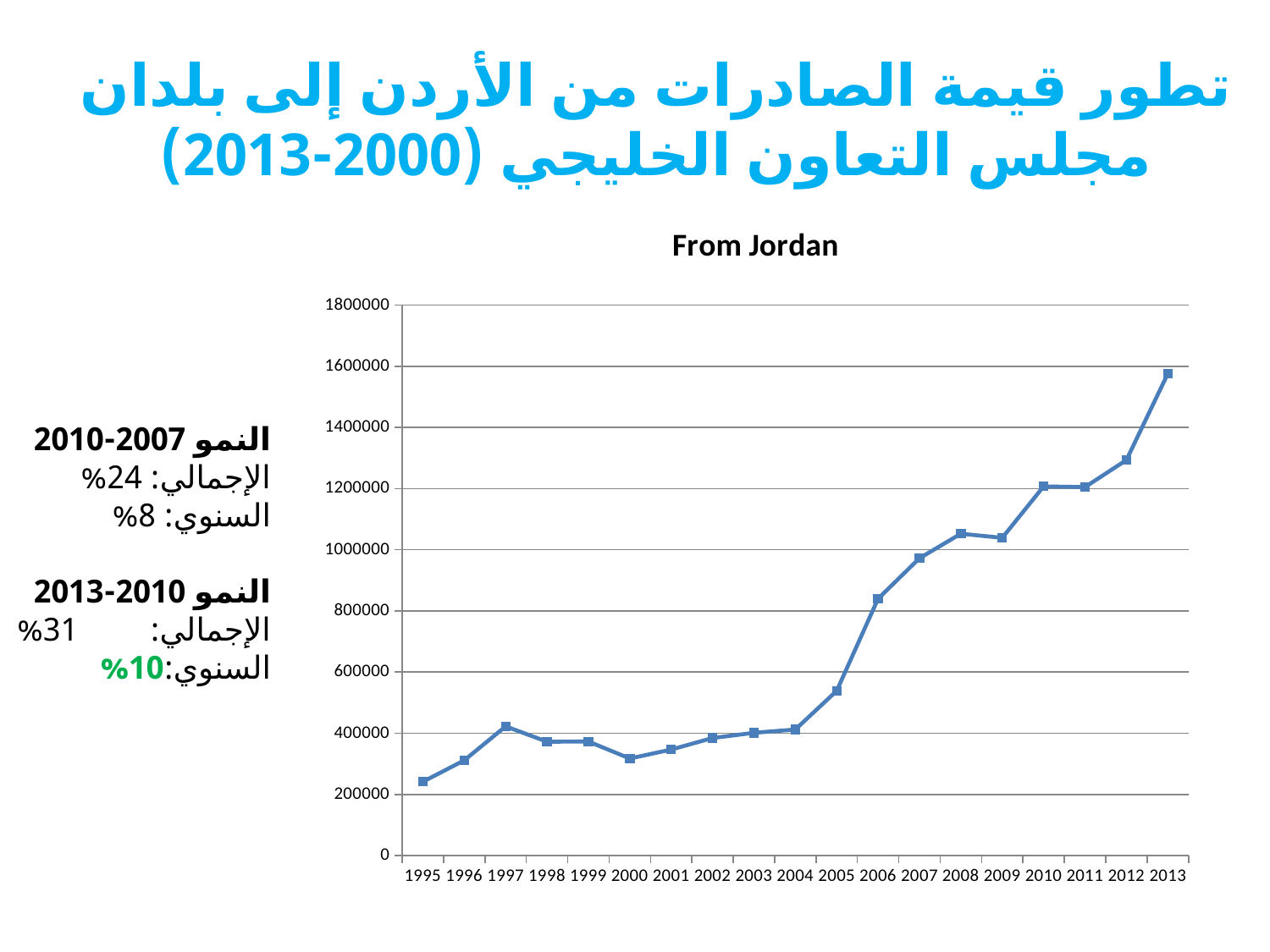
What kind of chart is shown on the slide? line chart Is the value for 2007 greater or less than 1000000? less How many years are plotted on the x axis of the chart? 19 Is the value for 2012 greater or less than 1200000? greater Which year has the highest value in the chart? 2013 Is the value for 2005 greater or less than 600000? less Overall, do the values rise or fall from 1995 to 2013? rise What is the title of the chart? From Jordan Which year has the larger value, 2005 or 2006? 2006 Which year has the lowest value in the chart? 1995